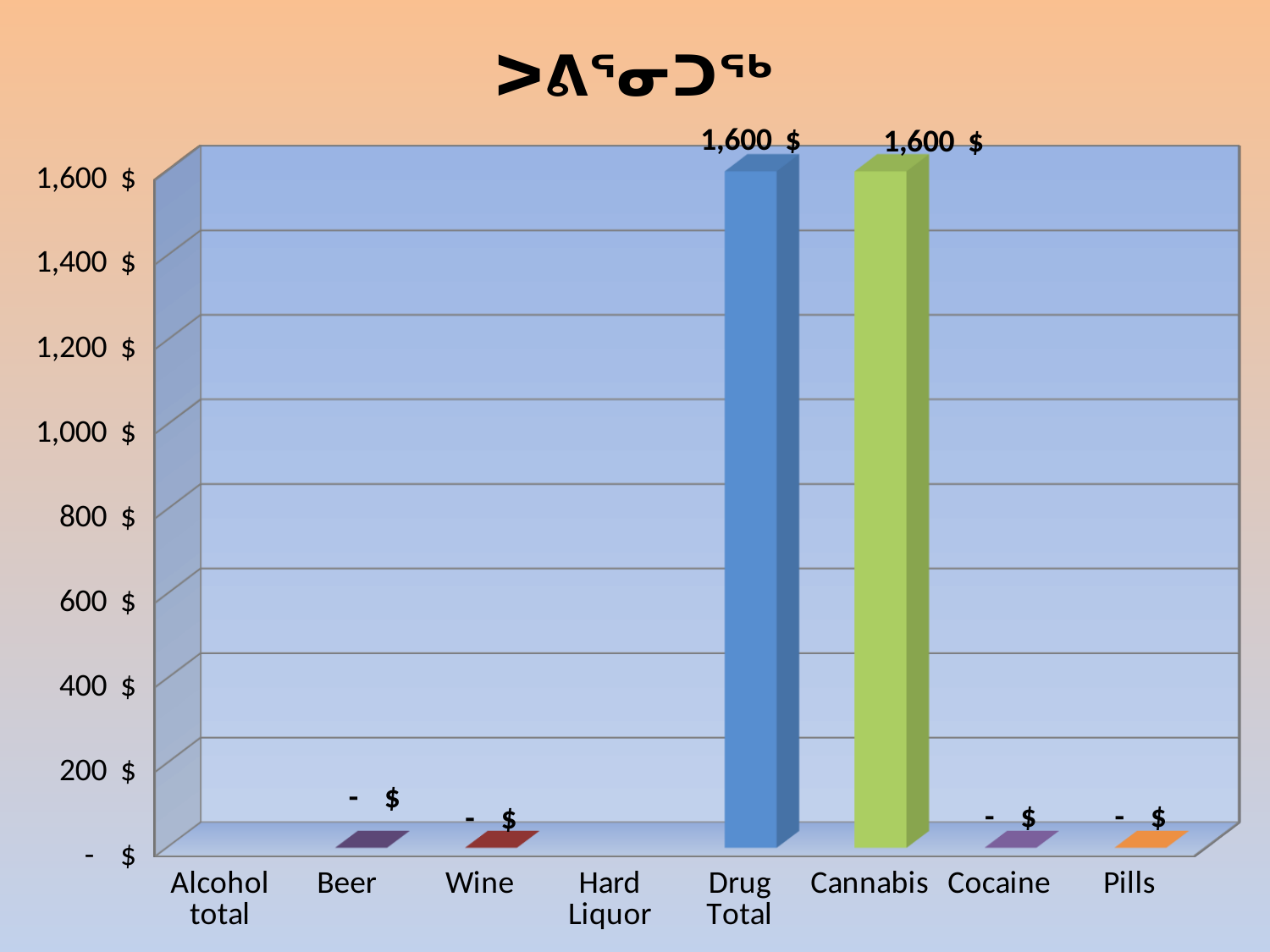
What is the value for Drug Total? 1,600 $ Is the value for Cannabis greater or less than 1,000 $? greater Which is larger, the value for Cannabis or the value for Cocaine? Cannabis Which categories have the highest value? Drug Total and Cannabis Is the value for Wine greater or less than 200 $? less What is the value shown for Pills? - $ What is the value for Cannabis? 1,600 $ What kind of chart is this? bar chart Which is larger, the value for Drug Total or the value for Beer? Drug Total What is the value shown for Beer? - $ What colour is the Drug Total bar? blue How many categories are shown on the x axis? 8